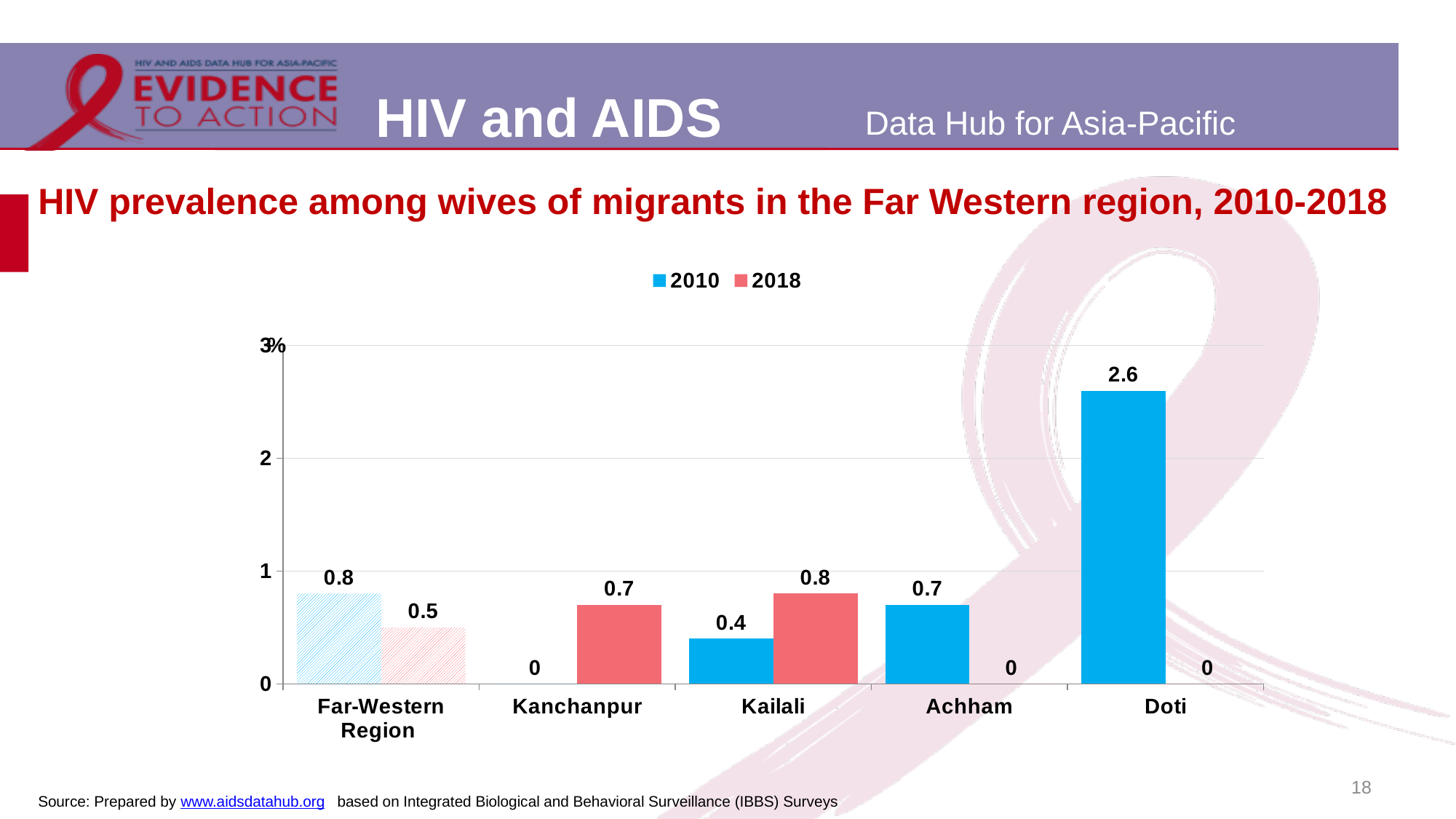
Which category has the highest 2018 value? Kailali What kind of chart is shown on the slide? bar chart Which series is shown in blue in the legend? 2010 How many categories are shown on the x axis? 5 How many series does the legend list? 2 What is the difference between the 2010 and 2018 values for Kailali? 0.4 What is the 2010 value for the Far-Western Region? 0.8 What is the 2018 value for Kailali? 0.8 Which category has the highest 2010 value? Doti Which is larger for the Far-Western Region, the 2010 value or the 2018 value? 2010 What is the 2018 value for Kanchanpur? 0.7 What is the 2010 value for Doti? 2.6